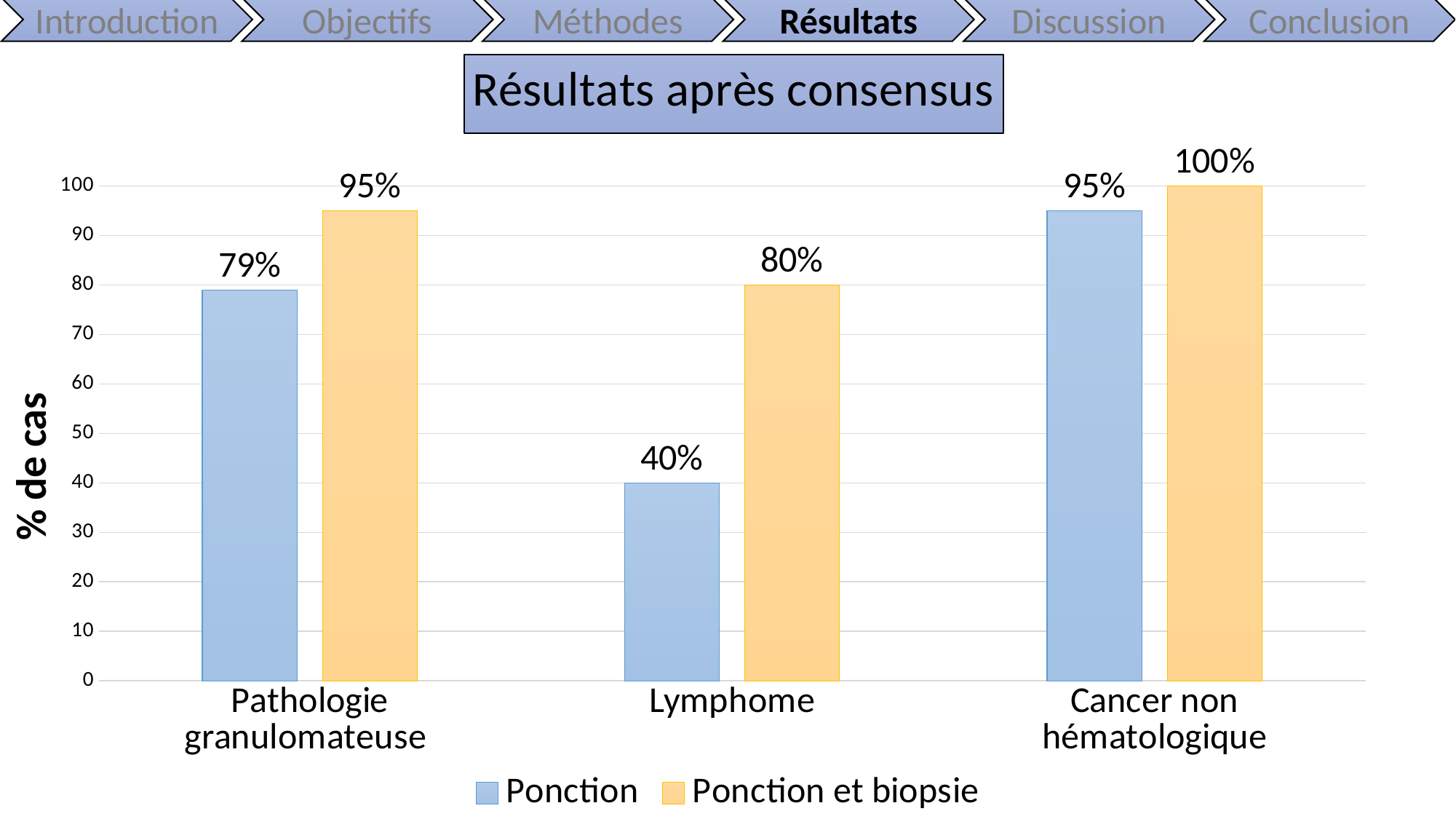
Which category has the lowest value for Ponction? Lymphome What is the value for Ponction in the Cancer non hématologique category? 95% Which category has the highest value for Ponction et biopsie? Cancer non hématologique What is the title of the chart? Résultats après consensus What kind of chart is shown on the slide? Bar chart What is the value for Ponction in the Lymphome category? 40% What is the difference between Ponction et biopsie and Ponction in the Pathologie granulomateuse category? 16% How many categories are shown on the x axis? 3 What is the difference between Ponction et biopsie and Ponction in the Lymphome category? 40% How many series does the legend list? 2 What is the value for Ponction et biopsie in the Pathologie granulomateuse category? 95% Which is larger in the Cancer non hématologique category: Ponction or Ponction et biopsie? Ponction et biopsie